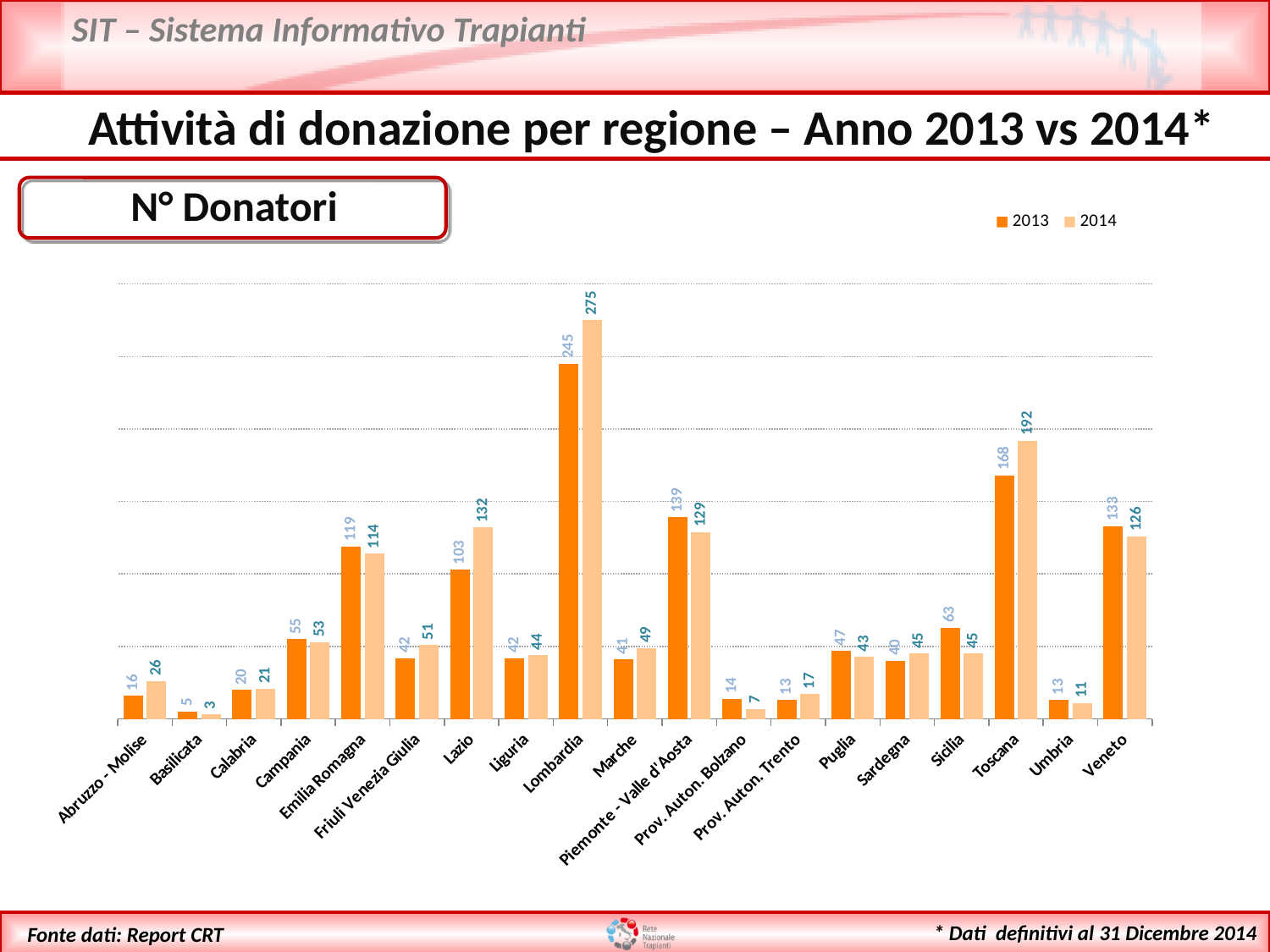
What is the 2013 value for Toscana? 168 What is the 2014 value for Lazio? 132 What is the difference between the 2013 and 2014 values for Sicilia? 18 How many series does the legend list? 2 Which region has the highest number of donors in 2013? Lombardia What is the difference between the 2014 and 2013 values for Lombardia? 30 How many regions are shown on the x axis? 19 How many donors did Lombardia have in 2014? 275 Which is larger for Piemonte - Valle d'Aosta, the 2013 value or the 2014 value? 2013 What type of chart is shown on the slide? Bar chart Which region had more donors in 2014, Veneto or Lazio? Lazio Which region has the lowest number of donors in 2014? Basilicata